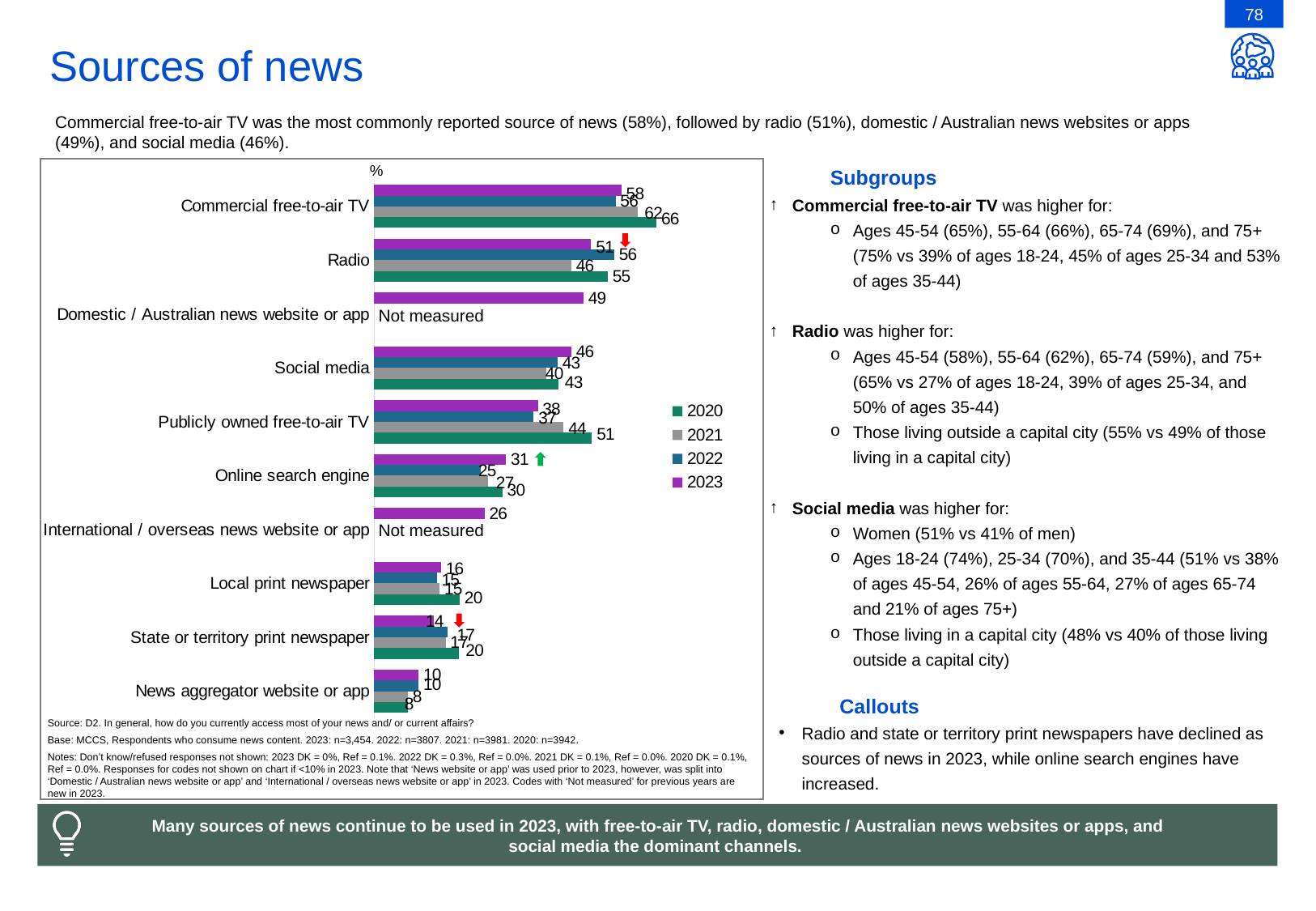
By how much did the value for Commercial free-to-air TV fall from 2020 to 2023? 8 What kind of chart is shown on the slide? Bar chart What is the difference between the 2023 and 2021 values for Social media? 6 Which source of news has the highest 2023 value? Commercial free-to-air TV What is the 2023 value for Online search engine? 31 For Radio, which year has the larger value, 2022 or 2023? 2022 Which source of news has the lowest 2023 value? News aggregator website or app What is the 2020 value for Commercial free-to-air TV? 66 How many sources of news are listed on the chart? 10 How many years does the legend list? 4 What is the 2023 value for Domestic / Australian news website or app? 49 What is the 2023 value for Radio? 51